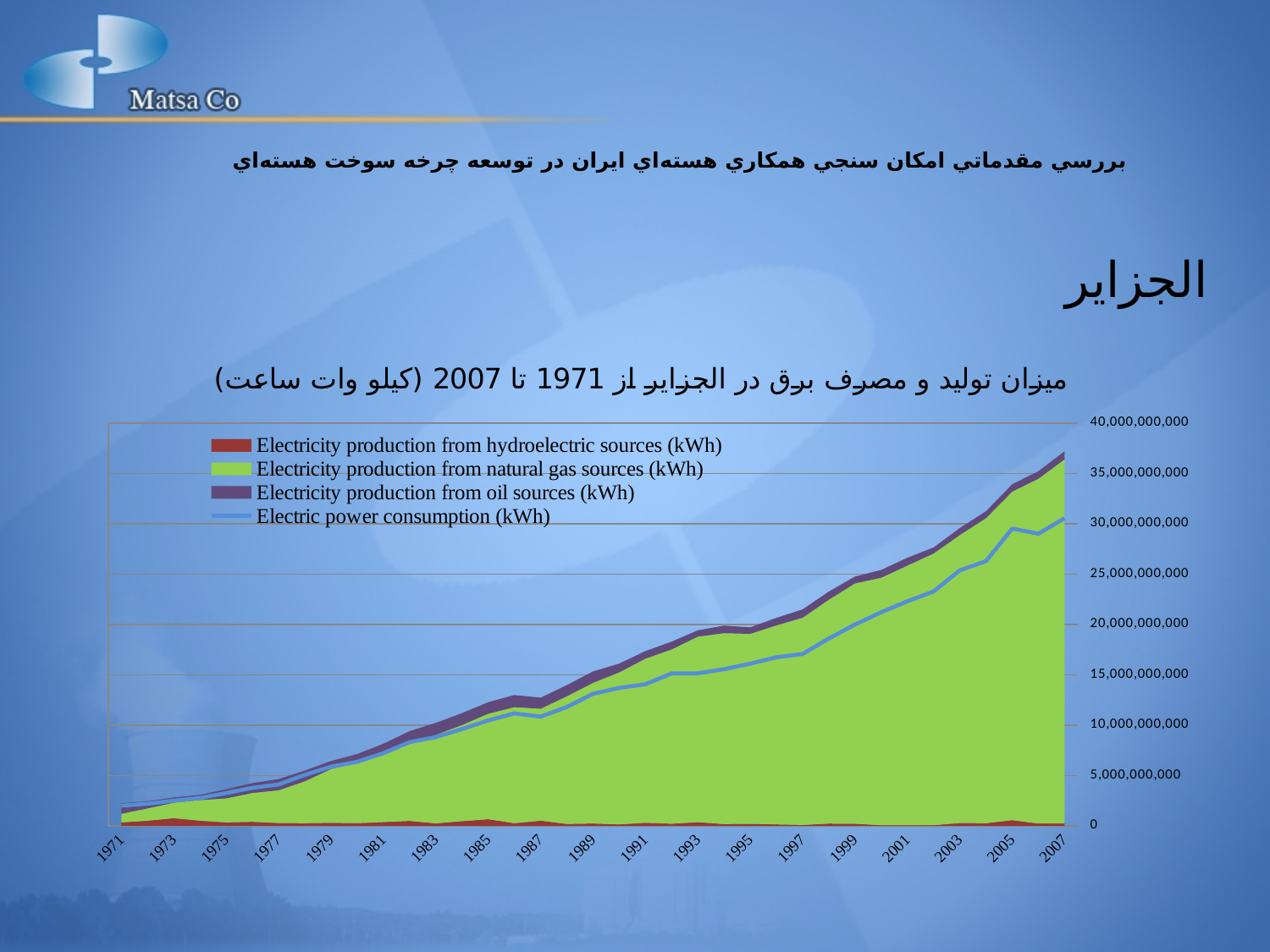
What colour represents electricity production from natural gas sources? green What kind of chart is shown on the slide? area and line chart How many series does the legend list? 4 Does electric power consumption rise or fall from 1971 to 2007? rise What is the first year shown on the x axis? 1971 What is the last year shown on the x axis? 2007 Is the value for electricity production from hydroelectric sources in 2007 greater or less than 5,000,000,000? less Is the value for electric power consumption in 2001 greater or less than 20,000,000,000? greater Is the value for electric power consumption in 1991 greater or less than 15,000,000,000? less What is the highest value shown on the y axis? 40,000,000,000 In 2007, which is larger: electricity production from natural gas sources or from hydroelectric sources? natural gas sources Which series is drawn as a line rather than a filled area? Electric power consumption (kWh)